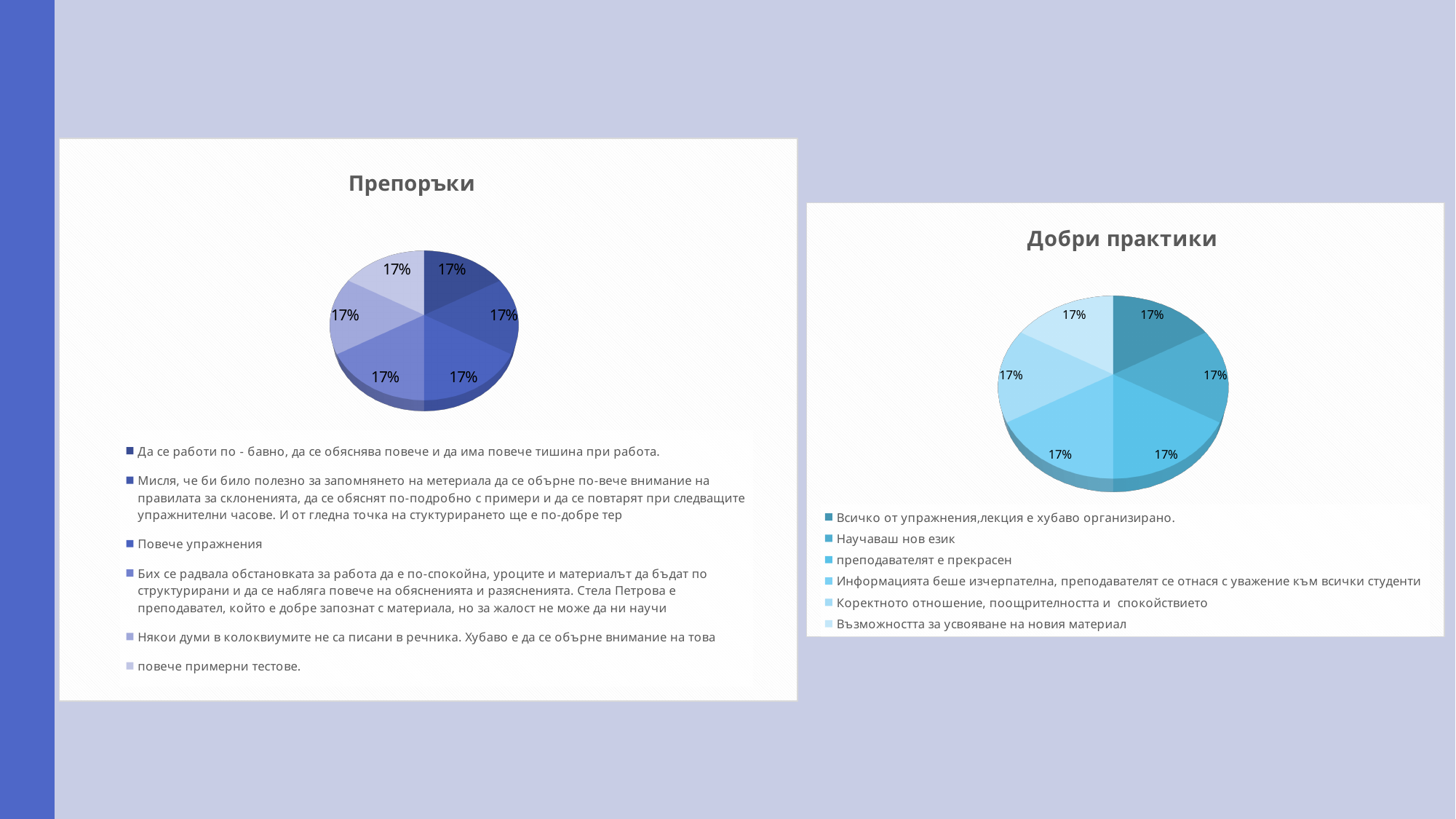
What kind of chart is the chart titled "Добри практики"? Pie chart In the chart titled "Добри практики", how many entries does the legend list? 6 What is the title of the chart on the left side of the slide? Препоръки In the chart titled "Добри практики", what share of the pie is labelled for the slice "Възможността за усвояване на новия материал"? 17% In the chart titled "Добри практики", how many slices does the pie have? 6 In the chart titled "Препоръки", how many entries does the legend list? 6 In the chart titled "Препоръки", how many slices does the pie have? 6 In the chart titled "Препоръки", what share of the pie is labelled for the slice "Повече упражнения"? 17% In the chart titled "Препоръки", what share of the pie is labelled for the slice "повече примерни тестове."? 17% What kind of chart is the chart titled "Препоръки"? Pie chart What is the title of the chart on the right side of the slide? Добри практики